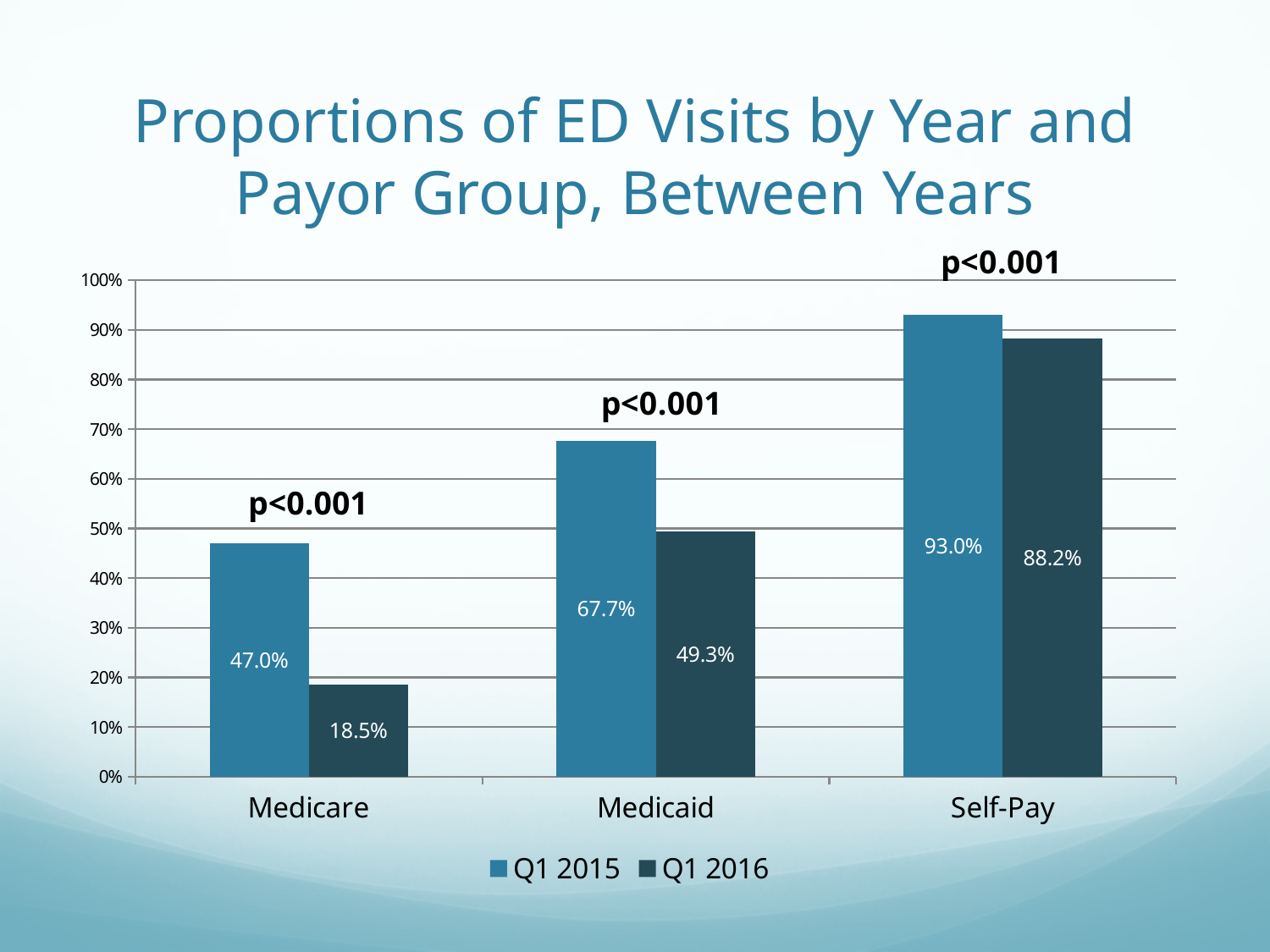
Which payor group has the highest Q1 2015 value? Self-Pay Which payor group has the lowest Q1 2016 value? Medicare What is the Q1 2016 value for Medicaid? 49.3% Which is larger for Self-Pay, the Q1 2015 value or the Q1 2016 value? Q1 2015 What is the Q1 2015 value for Medicare? 47.0% What is the Q1 2016 value for Self-Pay? 88.2% What kind of chart is shown on the slide? Bar chart How many payor groups are shown on the x axis? 3 Is the Q1 2015 value for Medicaid greater or less than 60%? greater What is the difference between the Q1 2015 and Q1 2016 values for Medicare? 28.5% What is the difference between the Q1 2015 and Q1 2016 values for Medicaid? 18.4% How many series does the legend list? 2